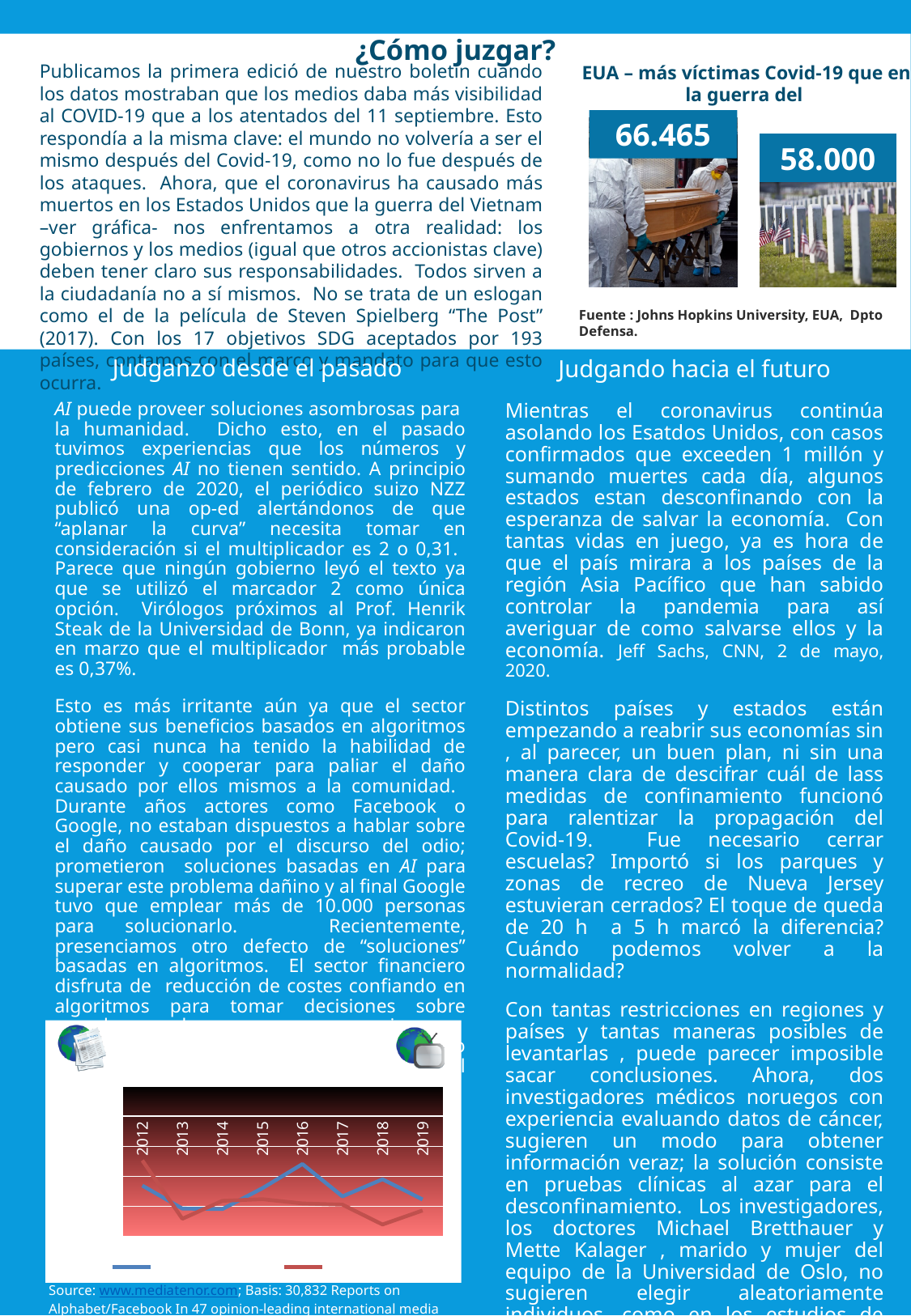
In the top-right comparison graphic, what is the difference between the Covid-19 figure and the Vietnam war figure? 8.465 In the top-right comparison graphic, which figure is larger, the Covid-19 victims or the Vietnam war victims? Covid-19 victims In the top-right comparison graphic, what figure is shown for Covid-19 victims in the USA? 66.465 How many years are shown on the x axis of the bottom-left line chart? 8 In the bottom-left line chart, which line is higher in 2018, the blue line or the red line? blue What is the last year on the x axis of the bottom-left line chart? 2019 How many series are plotted in the bottom-left line chart? 2 According to the source note under the bottom-left line chart, how many reports form the basis of the data? 30,832 What kind of chart is shown at the bottom left of the slide? line chart In the top-right comparison graphic, what figure is shown for the Vietnam war? 58.000 What is the first year on the x axis of the bottom-left line chart? 2012 In the bottom-left line chart, which line is higher in 2016, the blue line or the red line? blue